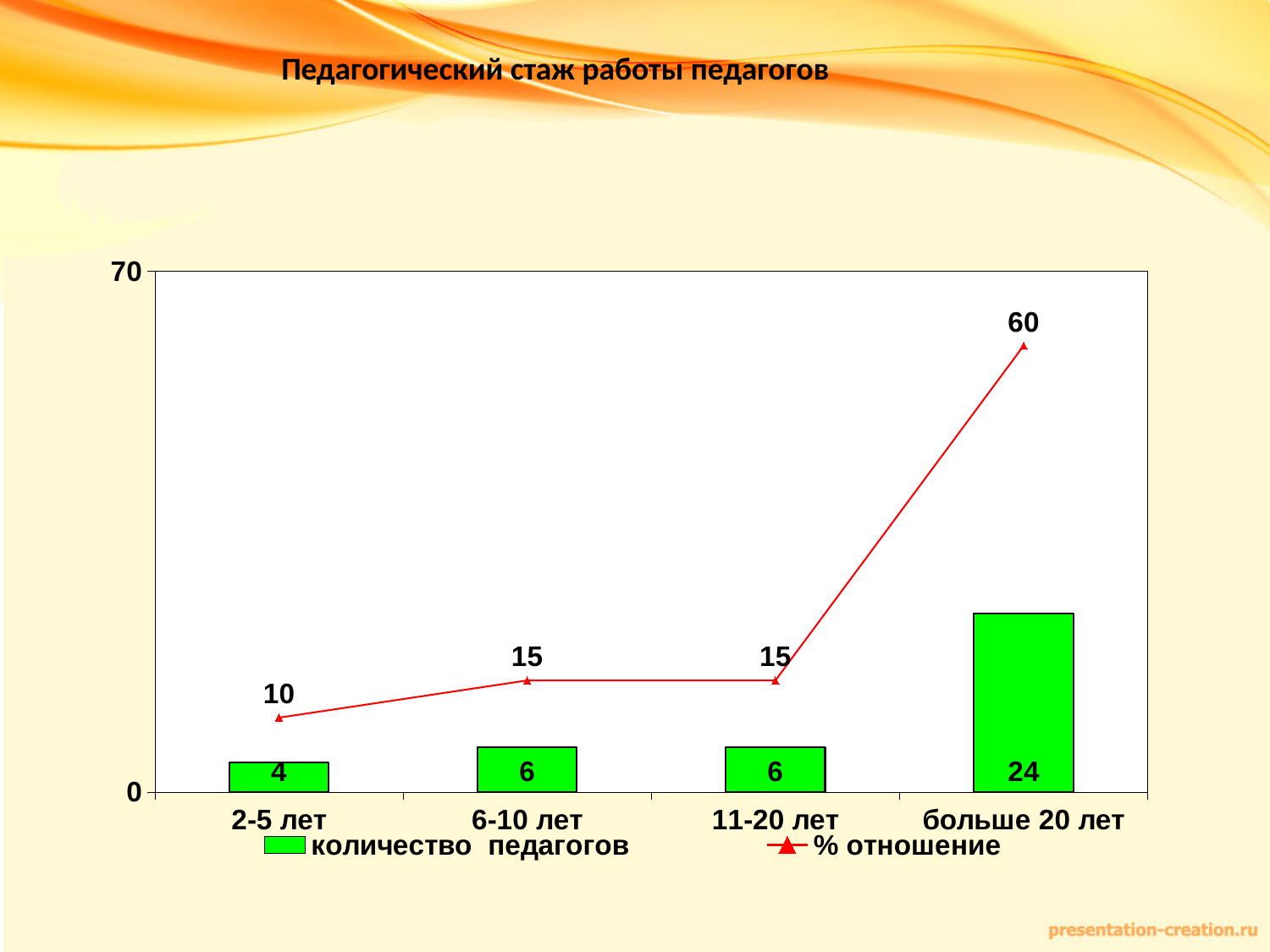
What is the number of teachers (количество педагогов) in the '2-5 лет' category? 4 What is the '% отношение' value for the 'больше 20 лет' category? 60 Which category has the lowest '% отношение' value? 2-5 лет How many categories are shown on the x axis? 4 What is the title of the slide? Педагогический стаж работы педагогов Which is larger: the '% отношение' value for '6-10 лет' or for '2-5 лет'? 6-10 лет Which category has the highest number of teachers? больше 20 лет Does the '% отношение' line rise or fall from '2-5 лет' to 'больше 20 лет'? Rises How many series does the legend list? 2 What is the difference in the number of teachers between 'больше 20 лет' and '6-10 лет'? 18 What kind of chart is shown on the slide? Combined bar and line chart What is the number of teachers in the '11-20 лет' category? 6